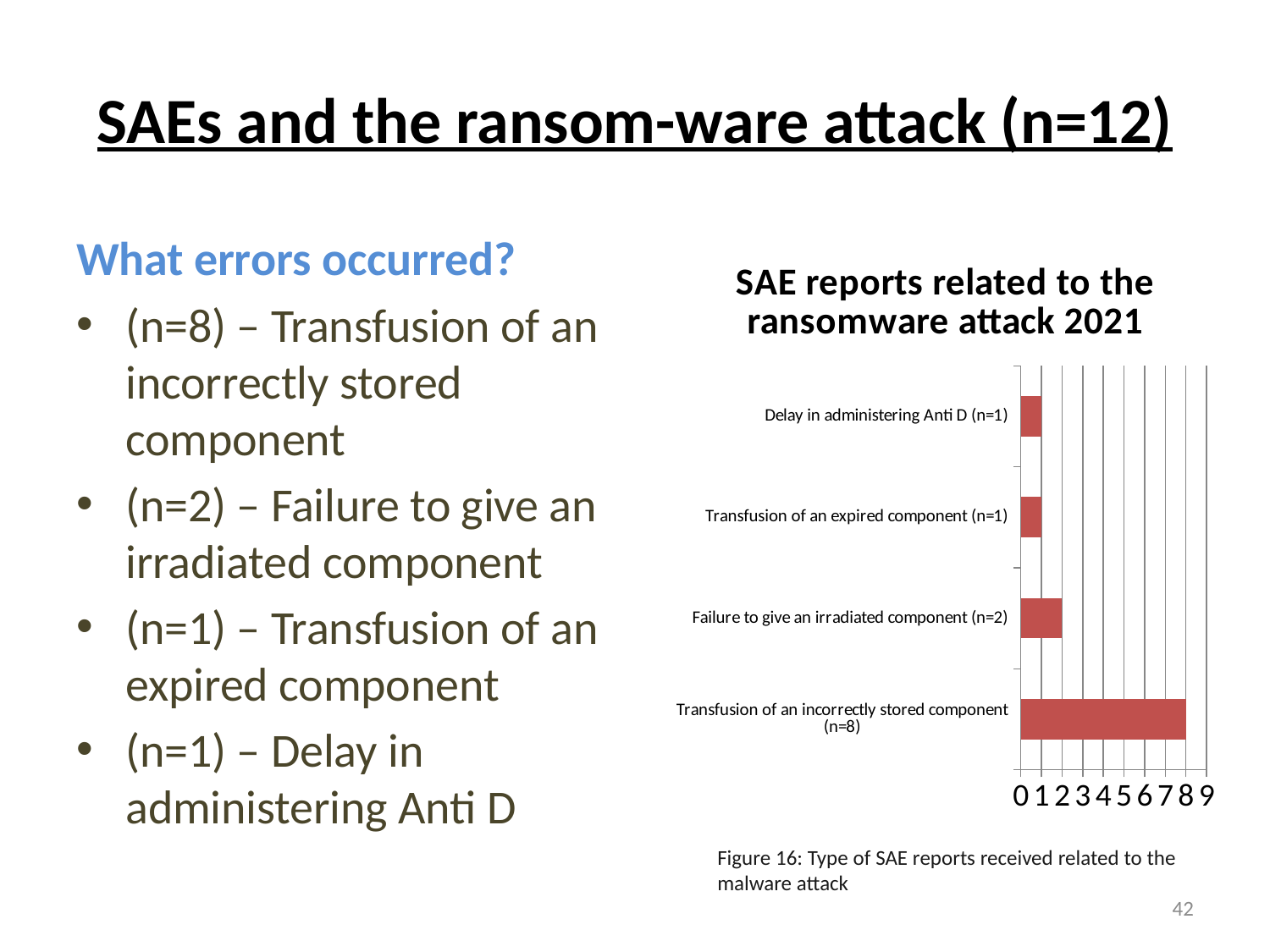
Which category has the highest value in the chart? Transfusion of an incorrectly stored component What type of chart is shown on the slide? bar chart What is the title of the chart? SAE reports related to the ransomware attack 2021 What is the value for Transfusion of an expired component? 1 What is the difference between the values for Transfusion of an incorrectly stored component and Failure to give an irradiated component? 6 What is the value for Transfusion of an incorrectly stored component? 8 Which is larger, the value for Failure to give an irradiated component or the value for Delay in administering Anti D? Failure to give an irradiated component Is the value for Transfusion of an incorrectly stored component greater or less than 5? greater What is the highest value shown on the chart's horizontal axis? 9 How many categories are plotted in the chart? 4 What is the value for Failure to give an irradiated component? 2 What is the value for Delay in administering Anti D? 1